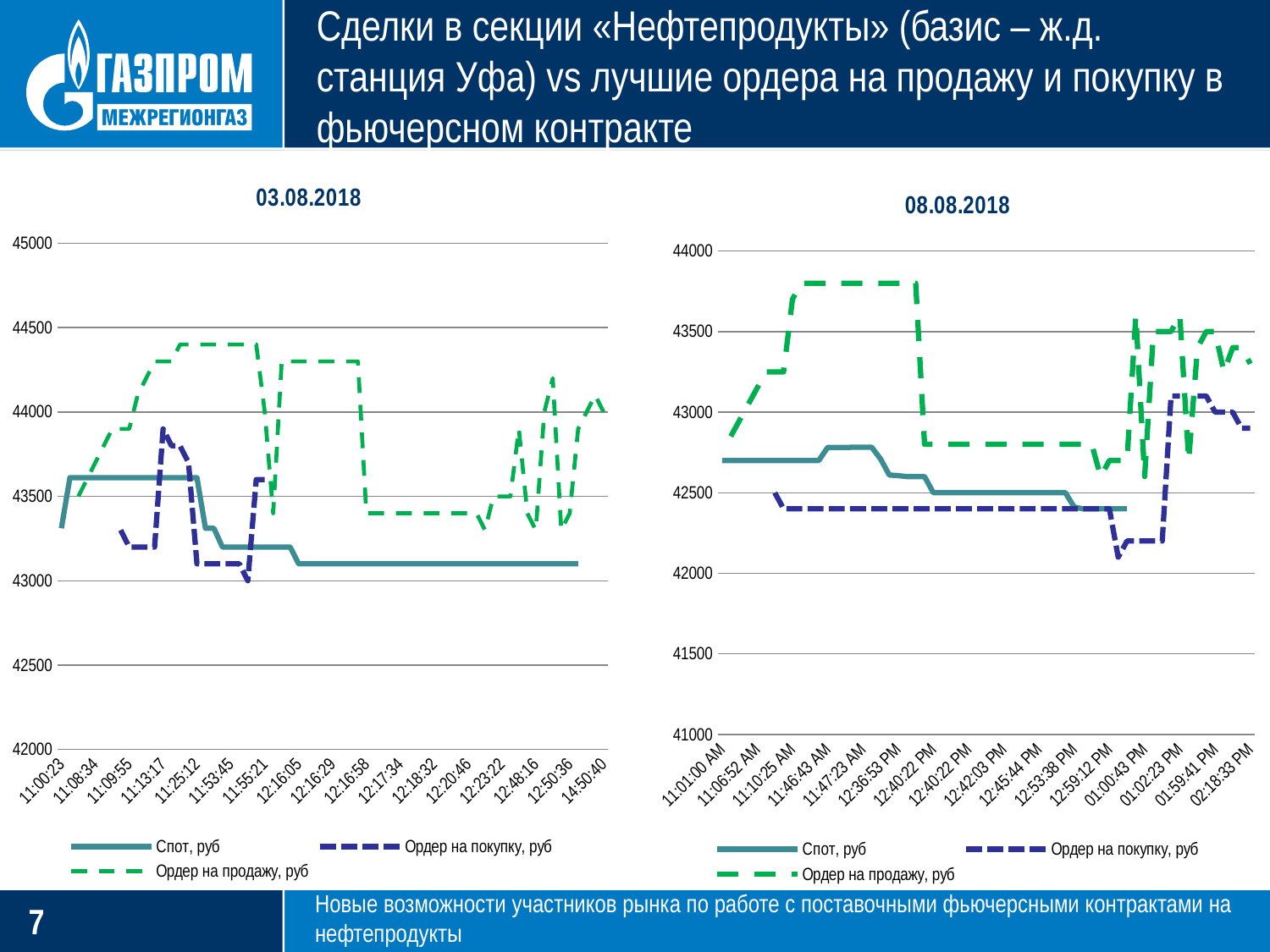
In the 08.08.2018 chart, is the value of Спот, руб at the first time point greater or less than 42500? greater In the 03.08.2018 chart, which series is drawn as a solid line? Спот, руб In the 08.08.2018 chart, is the lowest value of Ордер на покупку, руб greater or less than 42500? less What kind of chart is the chart titled 03.08.2018? Line chart In the 08.08.2018 chart, does Спот, руб rise or fall from the first time point to the last? Fall How many series does the legend of the 08.08.2018 chart list? 3 In the 08.08.2018 chart, at the last time point, which is higher: Ордер на продажу, руб or Ордер на покупку, руб? Ордер на продажу, руб What are the titles of the two charts on the slide? 03.08.2018 and 08.08.2018 In the 03.08.2018 chart, is the highest value of Ордер на продажу, руб greater or less than 44000? greater In the 03.08.2018 chart, does Спот, руб rise or fall from the first time point to the last? Fall